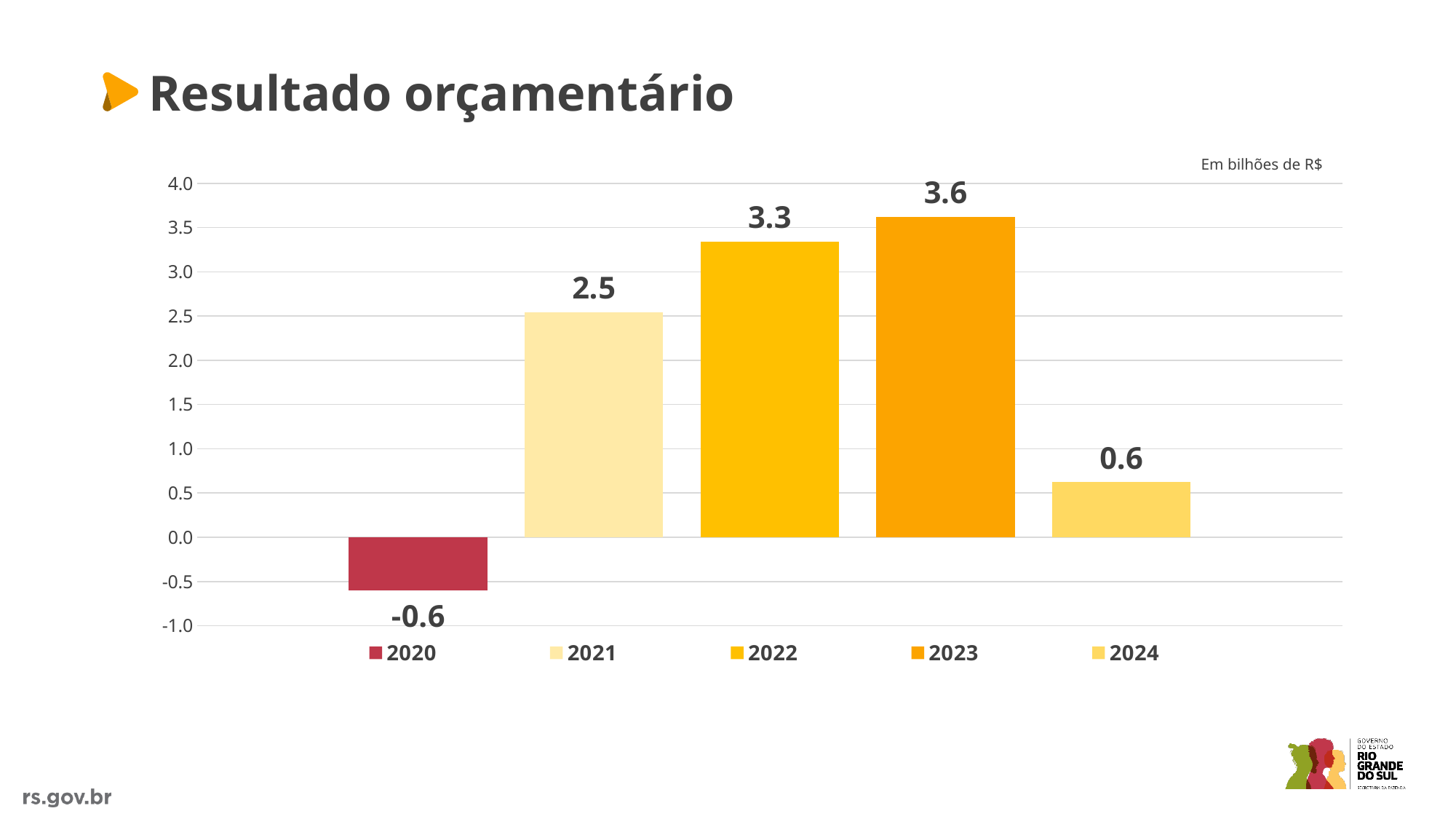
What kind of chart is shown on the slide? Bar chart What is the value for 2024? 0.6 What is the value for 2022? 3.3 What is the value for 2021? 2.5 What unit is stated for the values in the chart? Em bilhões de R$ What is the value for 2023? 3.6 What is the difference between the values for 2023 and 2022? 0.3 How many years are shown in the chart? 5 Which year has the lowest value? 2020 Which is larger, the value for 2021 or the value for 2024? 2021 Which year has the highest value? 2023 What is the value for 2020? -0.6